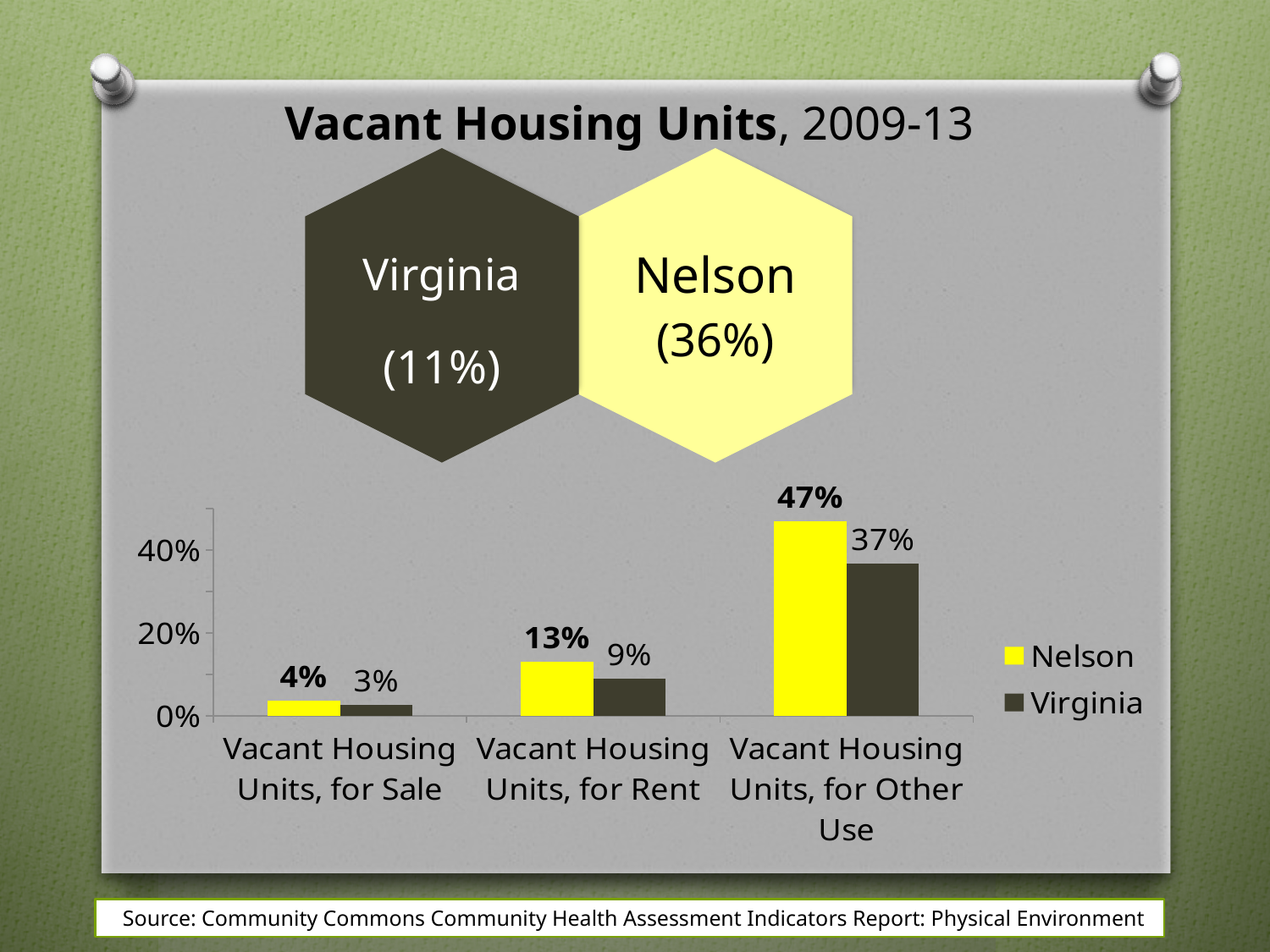
Is the value for Virginia for Vacant Housing Units, for Other Use greater or less than 20%? greater What kind of chart is shown on the slide? bar chart Which category has the lowest value for Virginia? Vacant Housing Units, for Sale Which is larger for Vacant Housing Units, for Sale: Nelson or Virginia? Nelson How many series does the legend list? 2 How many categories are shown on the x axis of the chart? 3 What is the difference between Nelson and Virginia for Vacant Housing Units, for Other Use? 10% Which category has the highest value for Nelson? Vacant Housing Units, for Other Use What is the value for Nelson for Vacant Housing Units, for Other Use? 47% What is the difference between Nelson and Virginia for Vacant Housing Units, for Rent? 4% What is the value for Virginia for Vacant Housing Units, for Rent? 9% What is the value for Virginia for Vacant Housing Units, for Sale? 3%